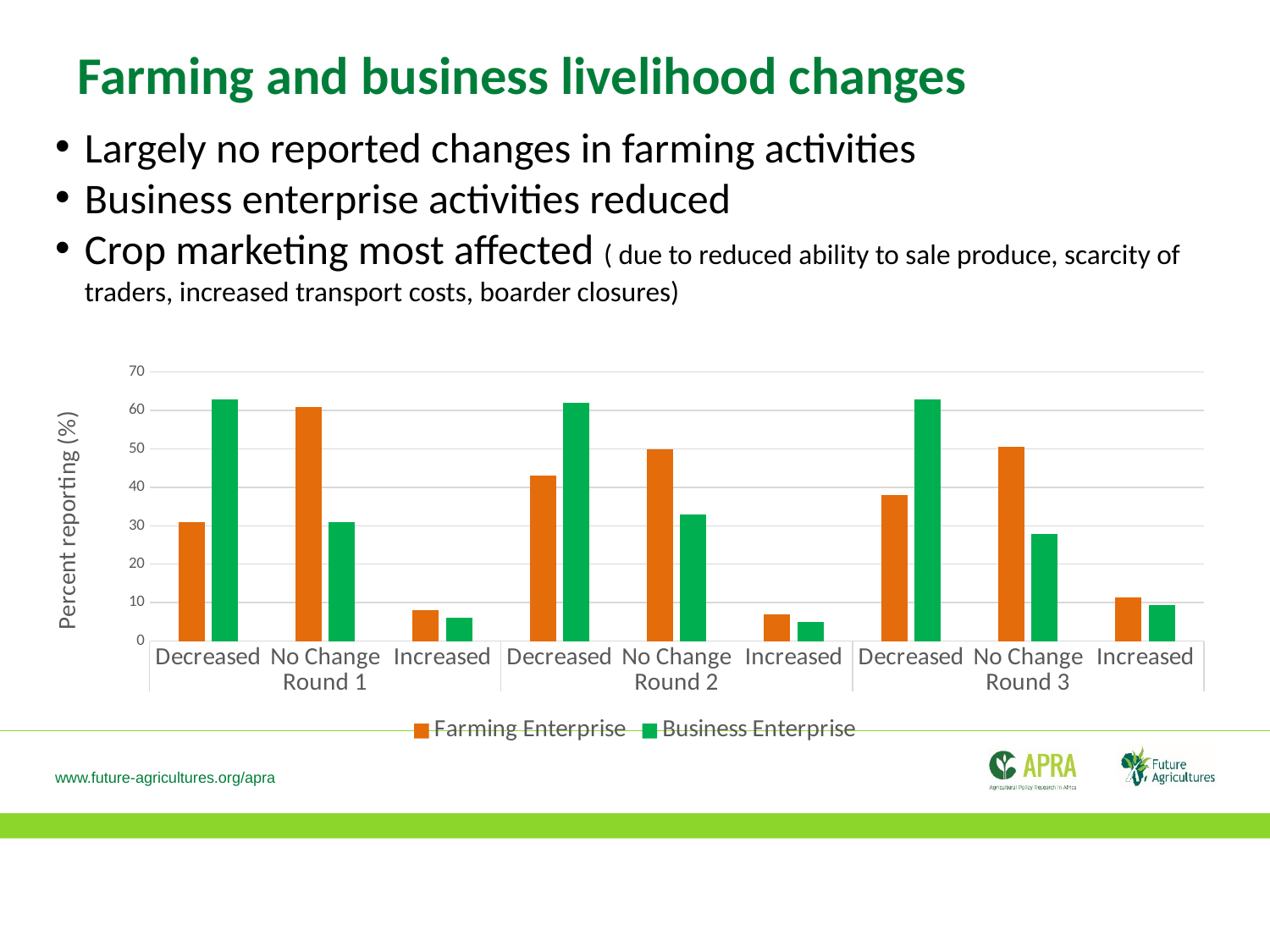
How many survey rounds are shown along the x axis of the chart? 3 In Round 3, which series has the larger value for No Change, Farming Enterprise or Business Enterprise? Farming Enterprise In Round 2, which series has the larger value for Decreased, Farming Enterprise or Business Enterprise? Business Enterprise In Round 3, which category has the lowest Business Enterprise value? Increased Is the Farming Enterprise value for No Change in Round 1 greater or less than 50? greater Is the Business Enterprise value for Decreased in Round 1 greater or less than 60? greater Which category and round has the highest Farming Enterprise value? No Change, Round 1 How many series does the chart legend list? 2 Is the Farming Enterprise value for Increased in Round 3 greater or less than 20? less What kind of chart is shown on the slide? Bar chart What is the label on the y axis of the chart? Percent reporting (%)